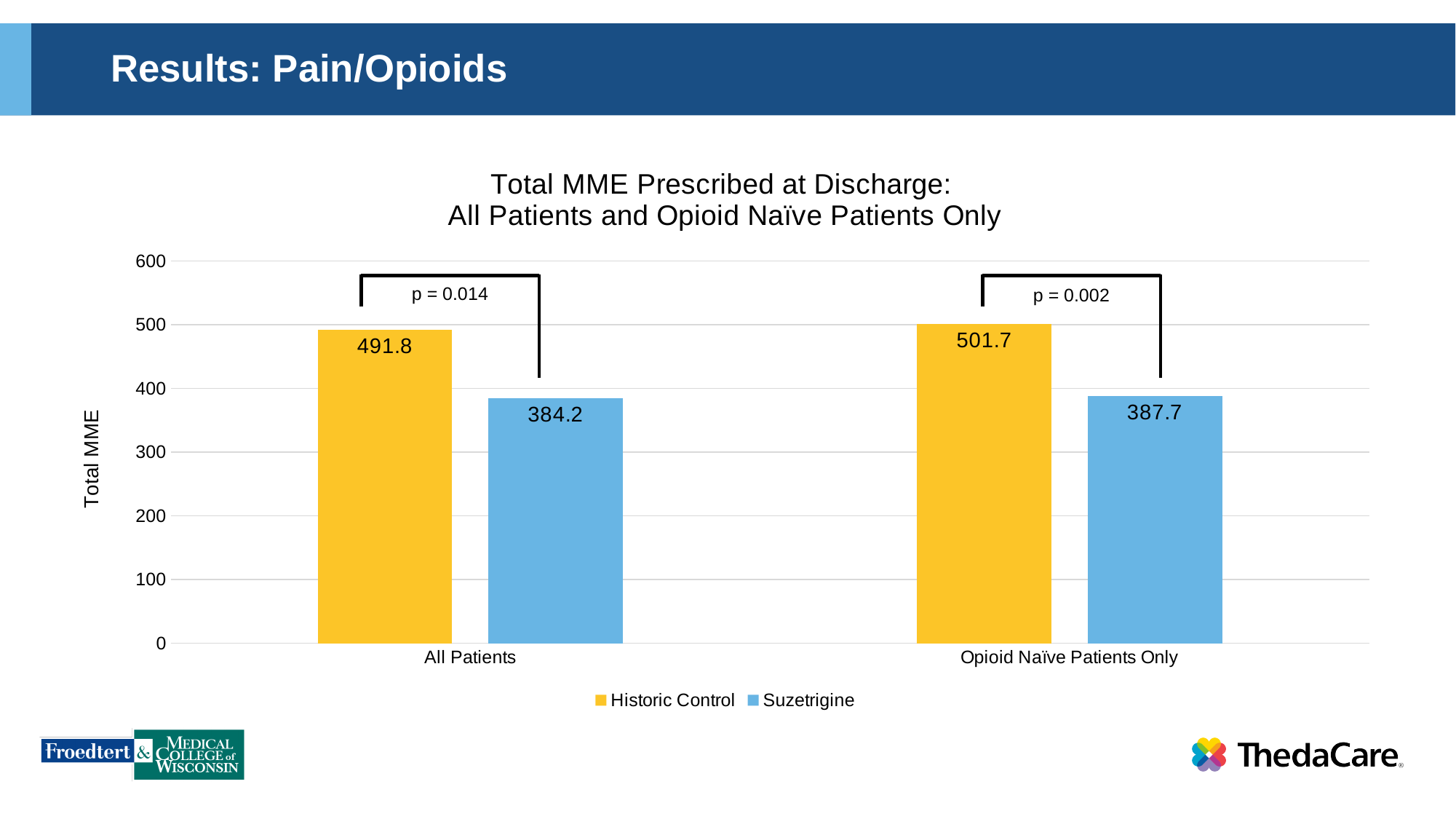
What is the difference between Historic Control and Suzetrigine in the All Patients group? 107.6 What is the Total MME for Historic Control in the All Patients group? 491.8 What p-value is shown for the Opioid Naïve Patients Only comparison? p = 0.002 What kind of chart is shown on the slide? Bar chart What is the Total MME for Suzetrigine in the All Patients group? 384.2 What is the Total MME for Suzetrigine in the Opioid Naïve Patients Only group? 387.7 Which is larger: Historic Control for All Patients or Historic Control for Opioid Naïve Patients Only? Historic Control for Opioid Naïve Patients Only Which bar has the highest Total MME on the chart? Historic Control, Opioid Naïve Patients Only What is the difference between Historic Control and Suzetrigine in the Opioid Naïve Patients Only group? 114 Which bar has the lowest Total MME on the chart? Suzetrigine, All Patients How many series does the legend list? 2 How many categories are shown on the x axis? 2